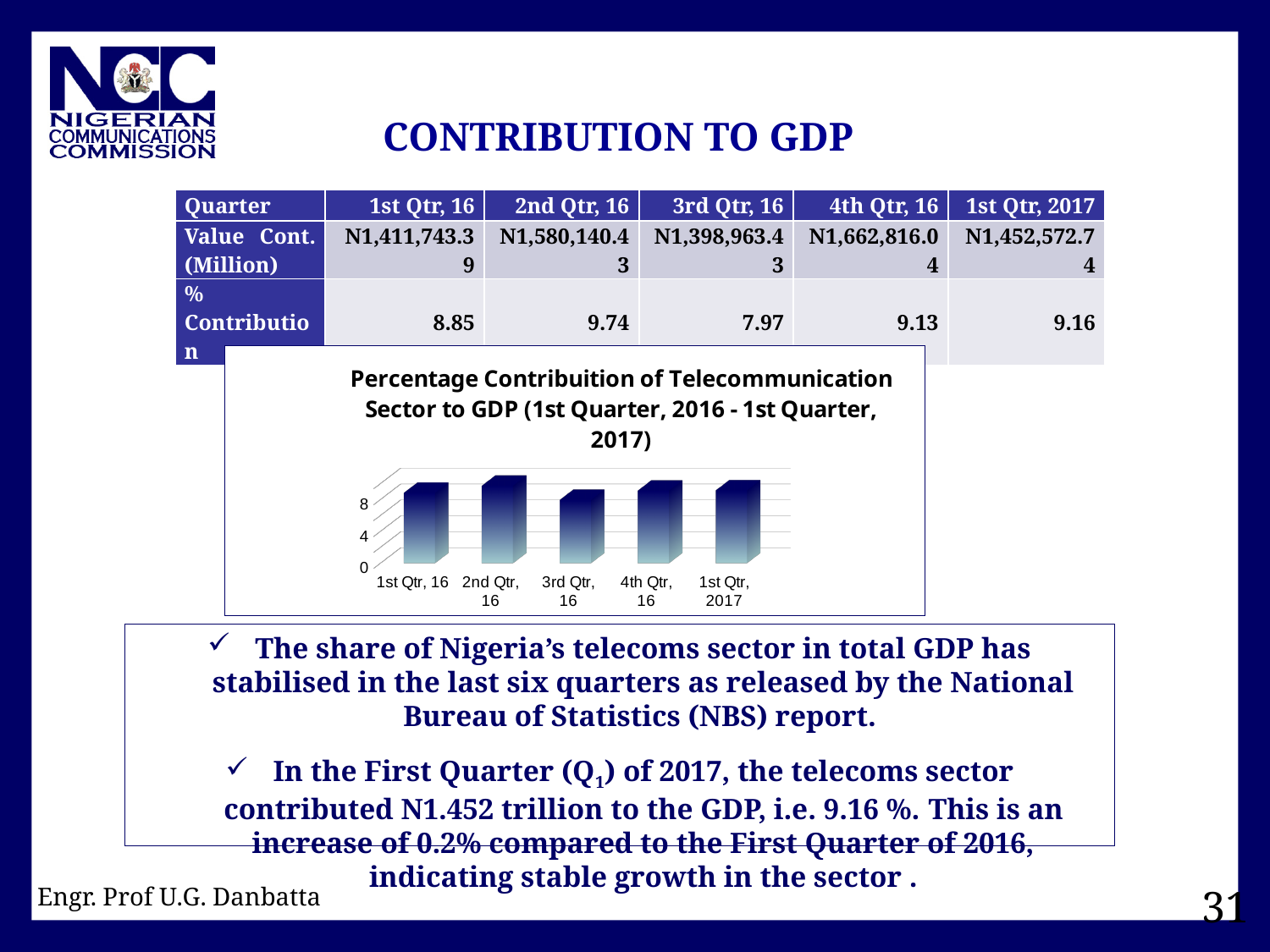
Is the value for 3rd Qtr, 16 greater or less than 4? greater How many quarters are plotted on the chart? 5 What is the percentage contribution for 2nd Qtr, 16? 9.74 What kind of chart is shown on the slide? bar chart Which quarter has the highest percentage contribution in the chart? 2nd Qtr, 16 What is the difference between the percentage contribution for 2nd Qtr, 16 and 3rd Qtr, 16? 1.77 What is the title of the chart? Percentage Contribuition of Telecommunication Sector to GDP (1st Quarter, 2016 - 1st Quarter, 2017) Which quarter has the lowest percentage contribution in the chart? 3rd Qtr, 16 Is the value for 1st Qtr, 16 greater or less than 8? greater Which is larger, the value for 2nd Qtr, 16 or the value for 3rd Qtr, 16? 2nd Qtr, 16 What is the percentage contribution for 1st Qtr, 2017? 9.16 Does the value rise or fall from 3rd Qtr, 16 to 4th Qtr, 16? rise